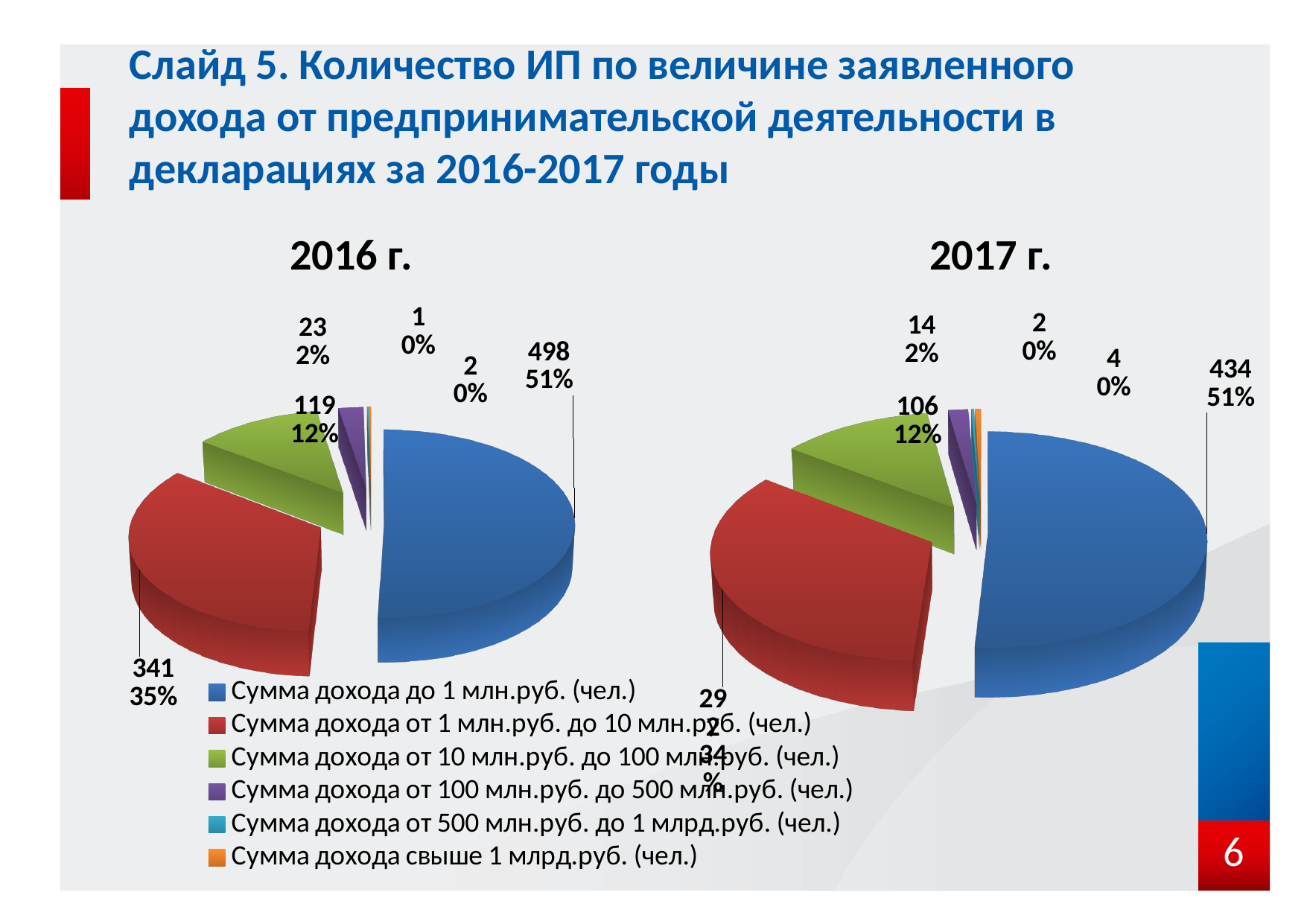
In the 2017 г. chart, what is the value for 'Сумма дохода от 10 млн.руб. до 100 млн.руб.'? 106 How many income categories does the legend list? 6 In the 2016 г. chart, what is the value for 'Сумма дохода от 1 млн.руб. до 10 млн.руб.'? 341 In the 2016 г. chart, what is the value for 'Сумма дохода от 10 млн.руб. до 100 млн.руб.'? 119 In the 2017 г. chart, what share of the pie is the category 'Сумма дохода от 10 млн.руб. до 100 млн.руб.'? 12% What type of chart is used on this slide for 2016 and 2017? Pie chart In the 2017 г. chart, what is the value for 'Сумма дохода до 1 млн.руб.'? 434 In the 2016 г. chart, what share of the pie is the category 'Сумма дохода до 1 млн.руб.'? 51% Which year has the larger value for 'Сумма дохода до 1 млн.руб.', 2016 or 2017? 2016 In the 2016 г. chart, how many individual entrepreneurs declared income up to 1 million rubles (Сумма дохода до 1 млн.руб.)? 498 In the 2016 г. chart, which category has the largest slice? Сумма дохода до 1 млн.руб. (чел.) By how much does the value for 'Сумма дохода до 1 млн.руб.' in the 2016 г. chart exceed the value in the 2017 г. chart? 64